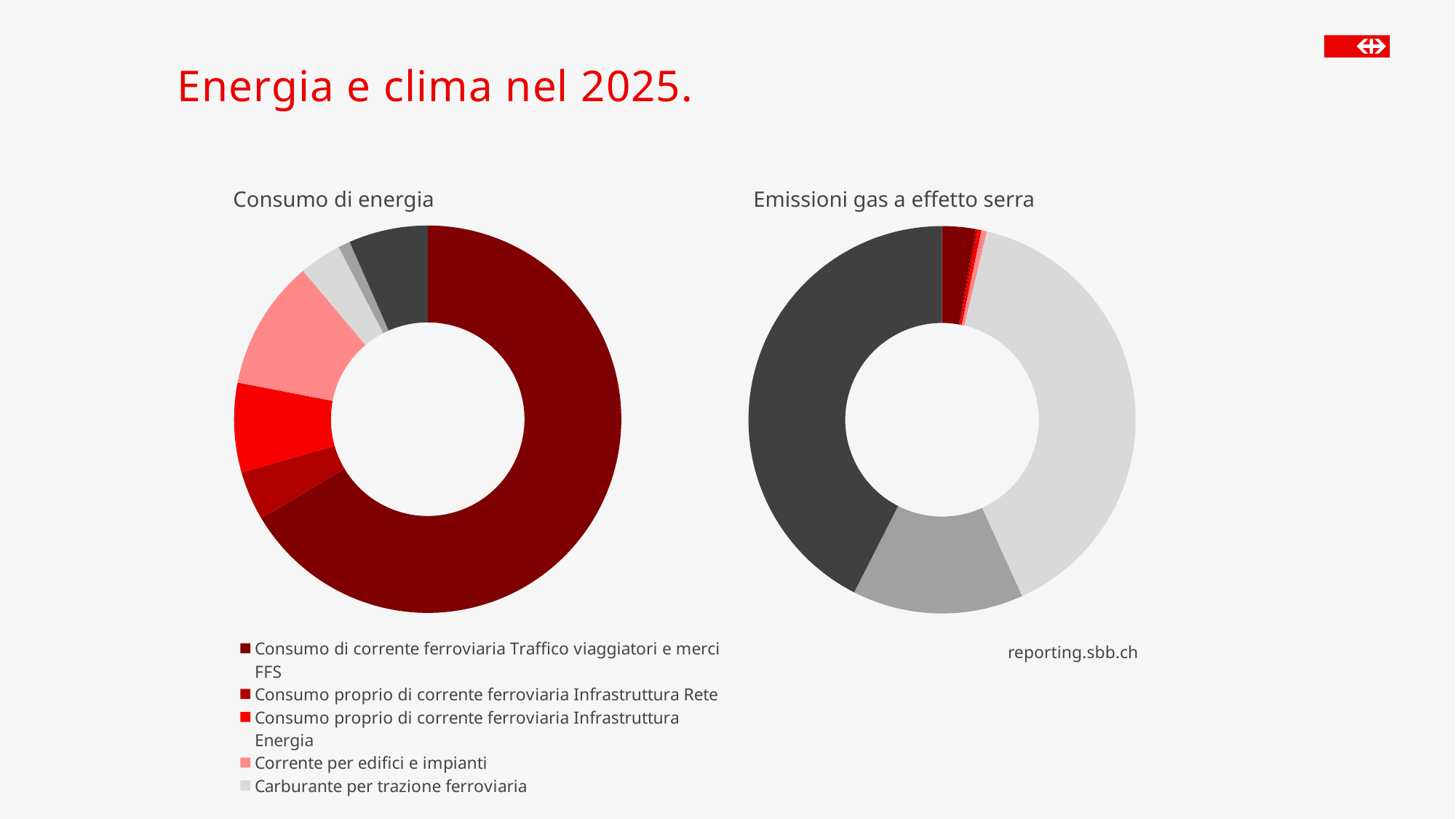
What source is cited below the 'Emissioni gas a effetto serra' chart? reporting.sbb.ch What is the title of the chart on the right of the slide? Emissioni gas a effetto serra In the 'Consumo di energia' chart, which is larger: 'Consumo proprio di corrente ferroviaria Infrastruttura Energia' or 'Consumo proprio di corrente ferroviaria Infrastruttura Rete'? Consumo proprio di corrente ferroviaria Infrastruttura Energia In the 'Consumo di energia' chart, which is larger: 'Corrente per edifici e impianti' or 'Carburante per trazione ferroviaria'? Corrente per edifici e impianti How many entries does the legend of the 'Consumo di energia' chart list? 5 What kind of chart is the 'Consumo di energia' chart? Doughnut chart In the 'Consumo di energia' chart, which is larger: 'Corrente per edifici e impianti' or 'Consumo proprio di corrente ferroviaria Infrastruttura Energia'? Corrente per edifici e impianti What kind of chart is the 'Emissioni gas a effetto serra' chart? Doughnut chart In the 'Consumo di energia' chart, which category has the largest share? Consumo di corrente ferroviaria Traffico viaggiatori e merci FFS